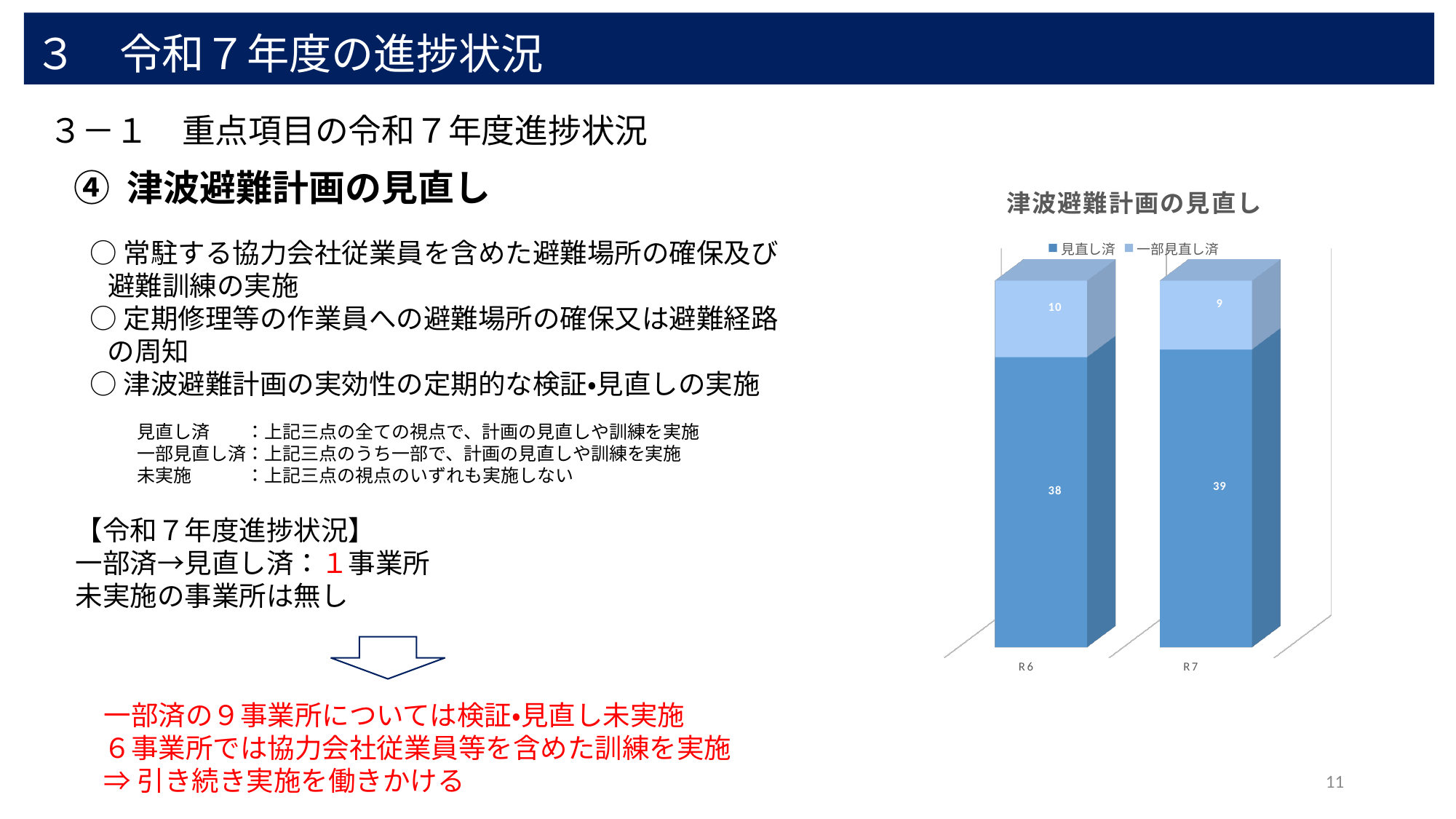
What is the value of 見直し済 for R7? 39 What kind of chart is shown? Stacked bar chart What is the value of 一部見直し済 for R7? 9 What is the value of 見直し済 for R6? 38 What is the title of the chart? 津波避難計画の見直し What is the total of the stacked bar for R6? 48 What is the value of 一部見直し済 for R6? 10 Which is larger, the 一部見直し済 value for R6 or for R7? R6 What is the total of the stacked bar for R7? 48 How many series does the legend list? 2 How many categories are shown on the x axis? 2 What is the difference between the 見直し済 values for R7 and R6? 1